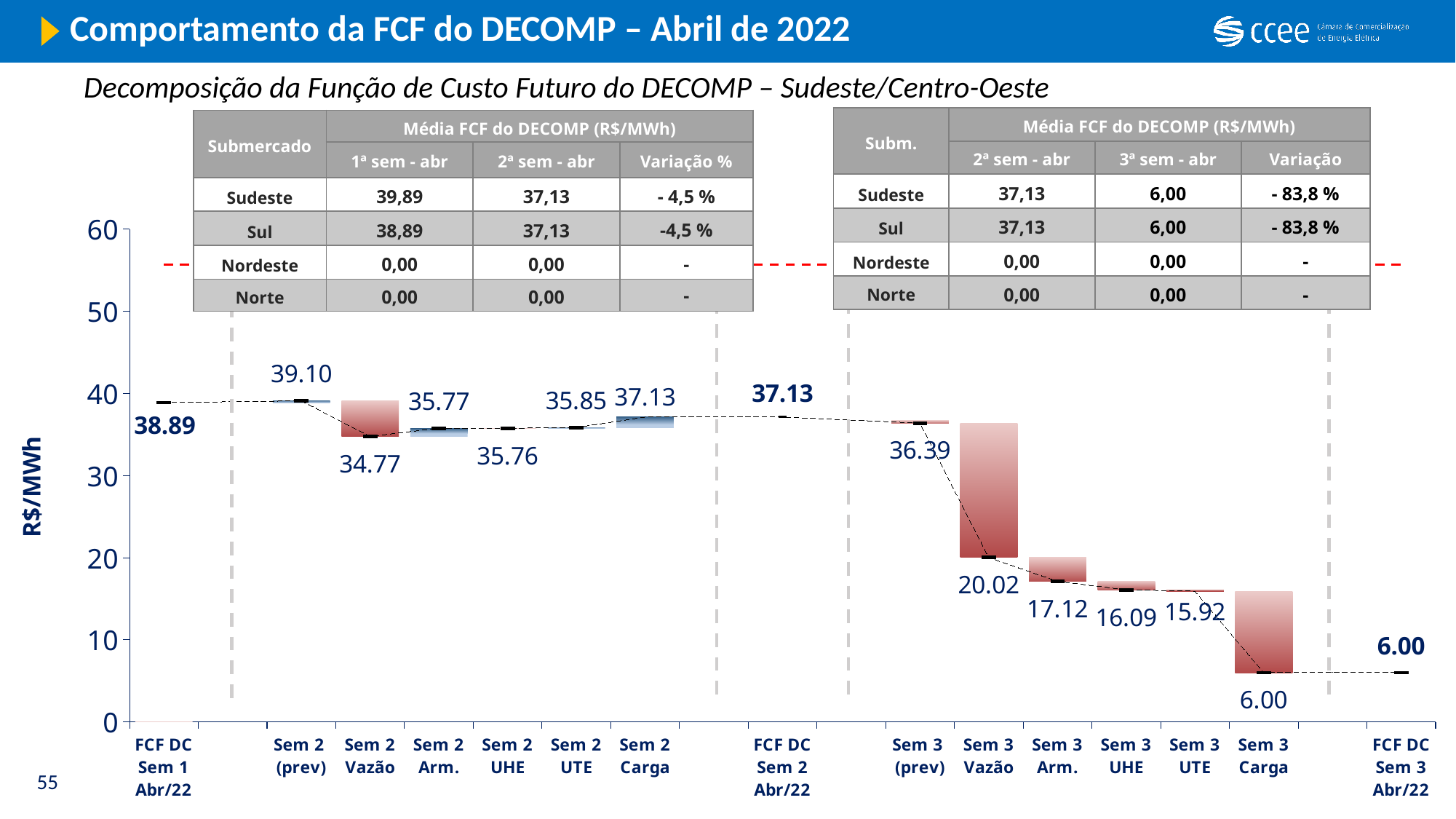
What is the difference between the values for Sem 3 (prev) and Sem 3 Vazão? 16.37 Which is larger, the value for Sem 2 Vazão or the value for Sem 2 Arm.? Sem 2 Arm. What is the value shown for FCF DC Sem 3 Abr/22? 6.00 What is the label of the y axis of the chart? R$/MWh Is the value for Sem 3 Arm. greater or less than 20? less What is the value shown for FCF DC Sem 1 Abr/22? 38.89 What is the difference between the values for FCF DC Sem 2 Abr/22 and FCF DC Sem 3 Abr/22? 31.13 How many categories are shown on the x axis of the chart? 15 Which category has the highest value in the chart? Sem 2 (prev) What is the value shown for Sem 2 Carga? 37.13 What is the value shown for Sem 3 Vazão? 20.02 What is the lowest value shown in the chart? 6.00